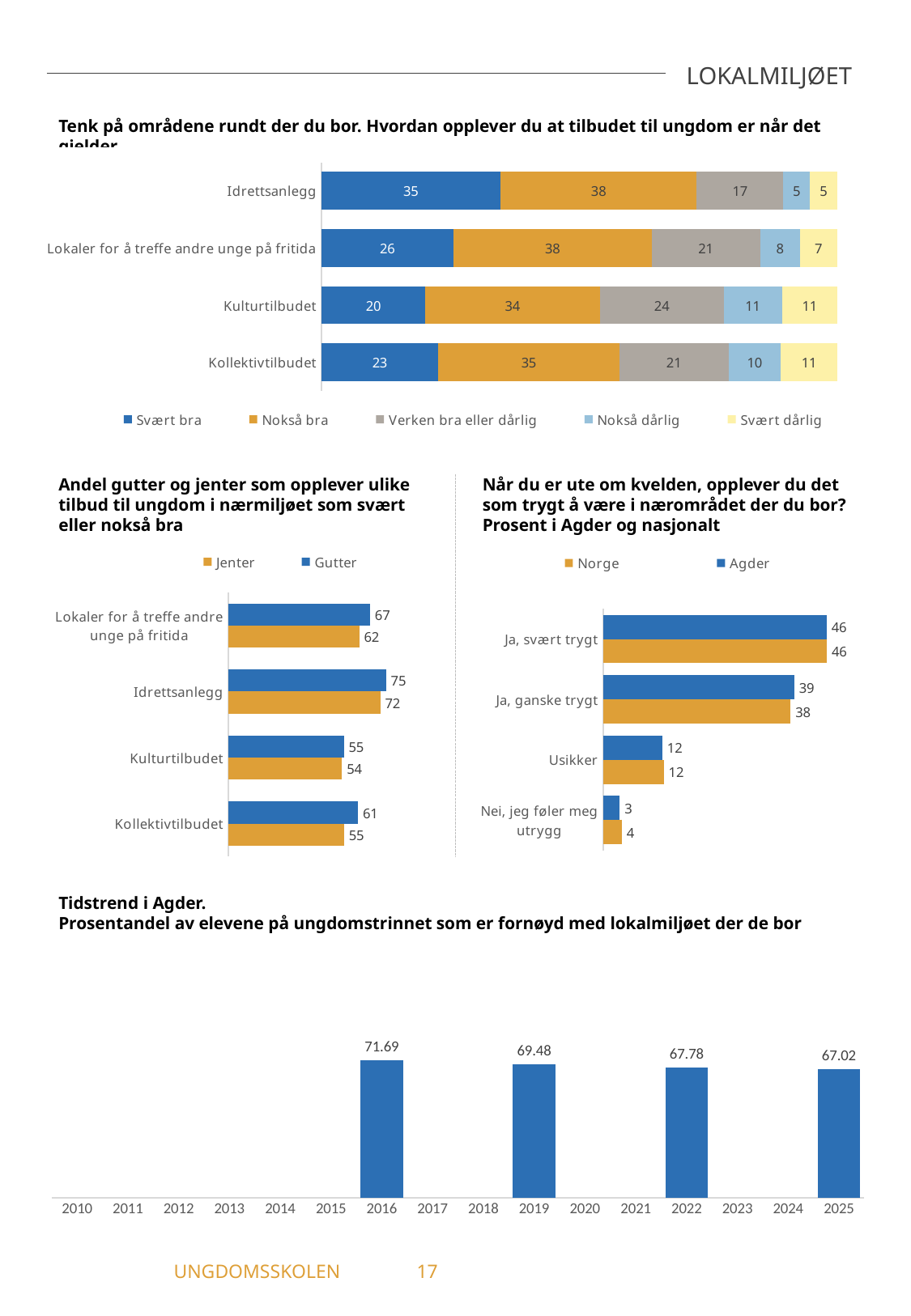
In the top stacked bar chart (Tenk på områdene rundt der du bor), which category has the highest 'Svært dårlig' value? Kulturtilbudet and Kollektivtilbudet (both 11) In the chart 'Andel gutter og jenter som opplever ulike tilbud til ungdom i nærmiljøet som svært eller nokså bra', what is the difference between Gutter and Jenter for Kollektivtilbudet? 6 In the top stacked bar chart (Tenk på områdene rundt der du bor), what is the value for 'Svært bra' for Idrettsanlegg? 35 In the chart 'Tidstrend i Agder', what is the value for 2019? 69.48 In the chart 'Når du er ute om kvelden, opplever du det som trygt å være i nærområdet der du bor?', how many categories are shown? 4 What kind of chart is 'Tidstrend i Agder'? bar chart In the chart 'Tidstrend i Agder', do the values rise or fall from 2016 to 2025? fall In the top stacked bar chart (Tenk på områdene rundt der du bor), how many series does the legend list? 5 In the chart 'Andel gutter og jenter som opplever ulike tilbud til ungdom i nærmiljøet som svært eller nokså bra', which category has the lowest Jenter value? Kulturtilbudet In the chart 'Andel gutter og jenter som opplever ulike tilbud til ungdom i nærmiljøet som svært eller nokså bra', what is the value for Gutter for Idrettsanlegg? 75 In the top stacked bar chart (Tenk på områdene rundt der du bor), what is the difference between the 'Nokså bra' values for Idrettsanlegg and Kulturtilbudet? 4 In the chart 'Når du er ute om kvelden, opplever du det som trygt å være i nærområdet der du bor?', what is the value for Norge for 'Nei, jeg føler meg utrygg'? 4